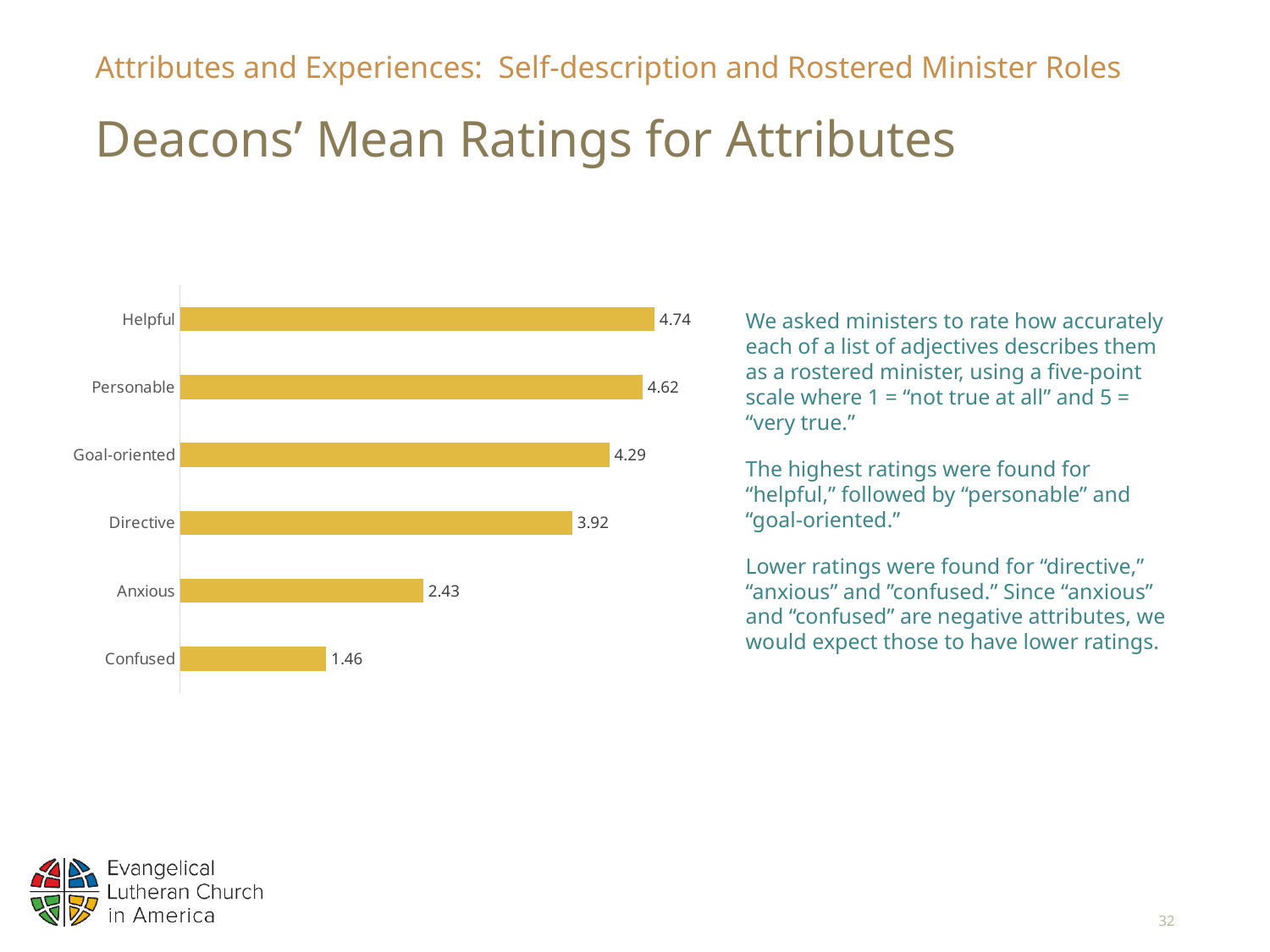
What is the mean rating for "Helpful"? 4.74 Which attribute has the highest mean rating? Helpful What is the difference between the mean ratings for "Personable" and "Goal-oriented"? 0.33 How many attributes are shown in the chart? 6 Which has a higher mean rating, "Directive" or "Anxious"? Directive What is the difference between the mean ratings for "Helpful" and "Confused"? 3.28 Which attribute has the lowest mean rating? Confused What is the title of the chart on the slide? Deacons' Mean Ratings for Attributes Do the mean ratings increase or decrease going from the top bar to the bottom bar? Decrease What is the mean rating for "Directive"? 3.92 What is the mean rating for "Anxious"? 2.43 What kind of chart is shown on the slide? Bar chart